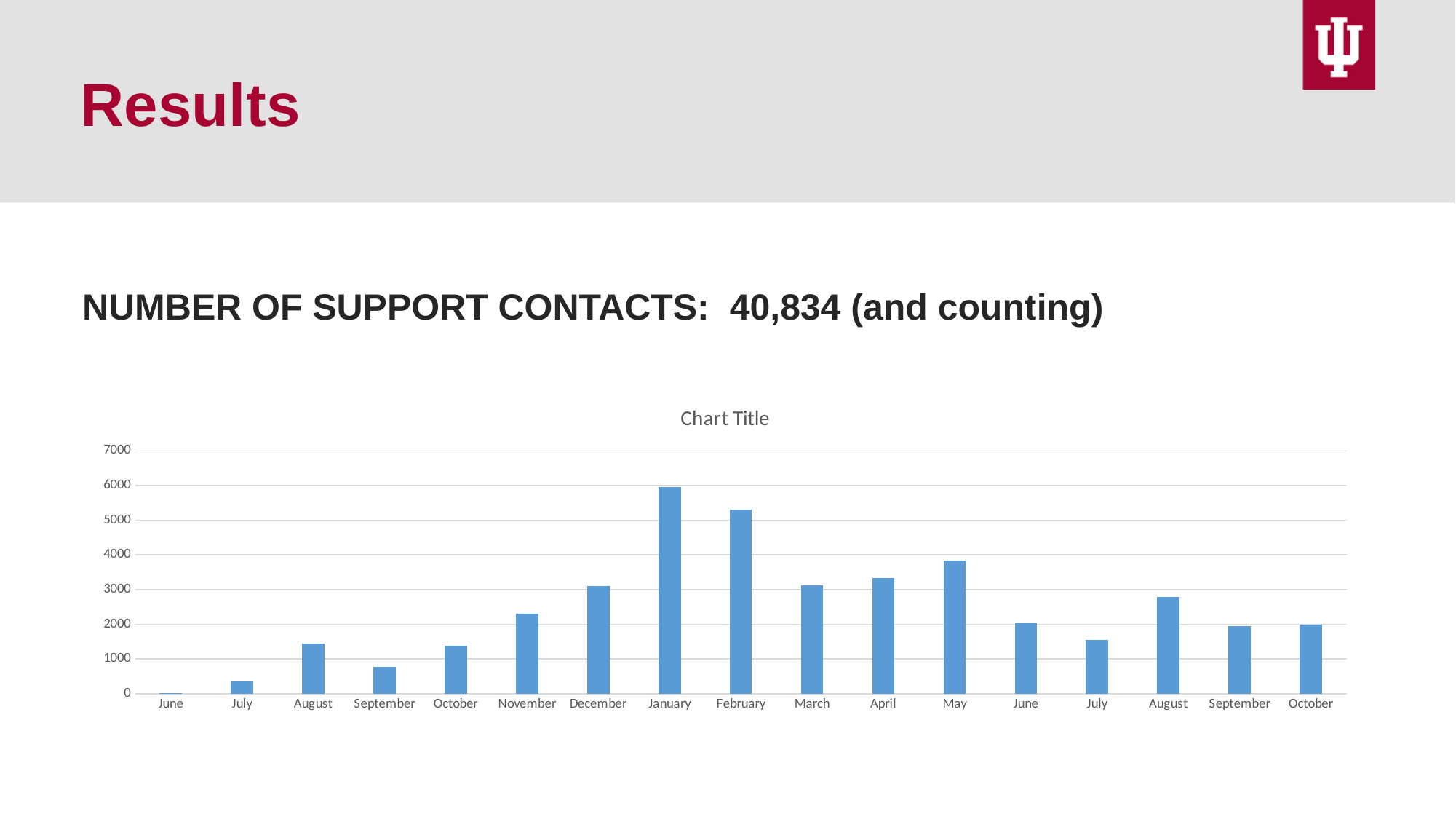
Is the value for the first July bar greater or less than 1000? less Is the value for May greater or less than 3000? greater How many bars (categories) are plotted in the chart? 17 Is the value for the first September bar greater or less than 1000? less Do the values rise or fall from November through January? rise Which bar is the lowest in the chart? the first June What kind of chart is shown on the slide? bar chart Which is larger, the value for January or the value for February? January What is the title shown above the chart? Chart Title Which month has the highest bar in the chart? January